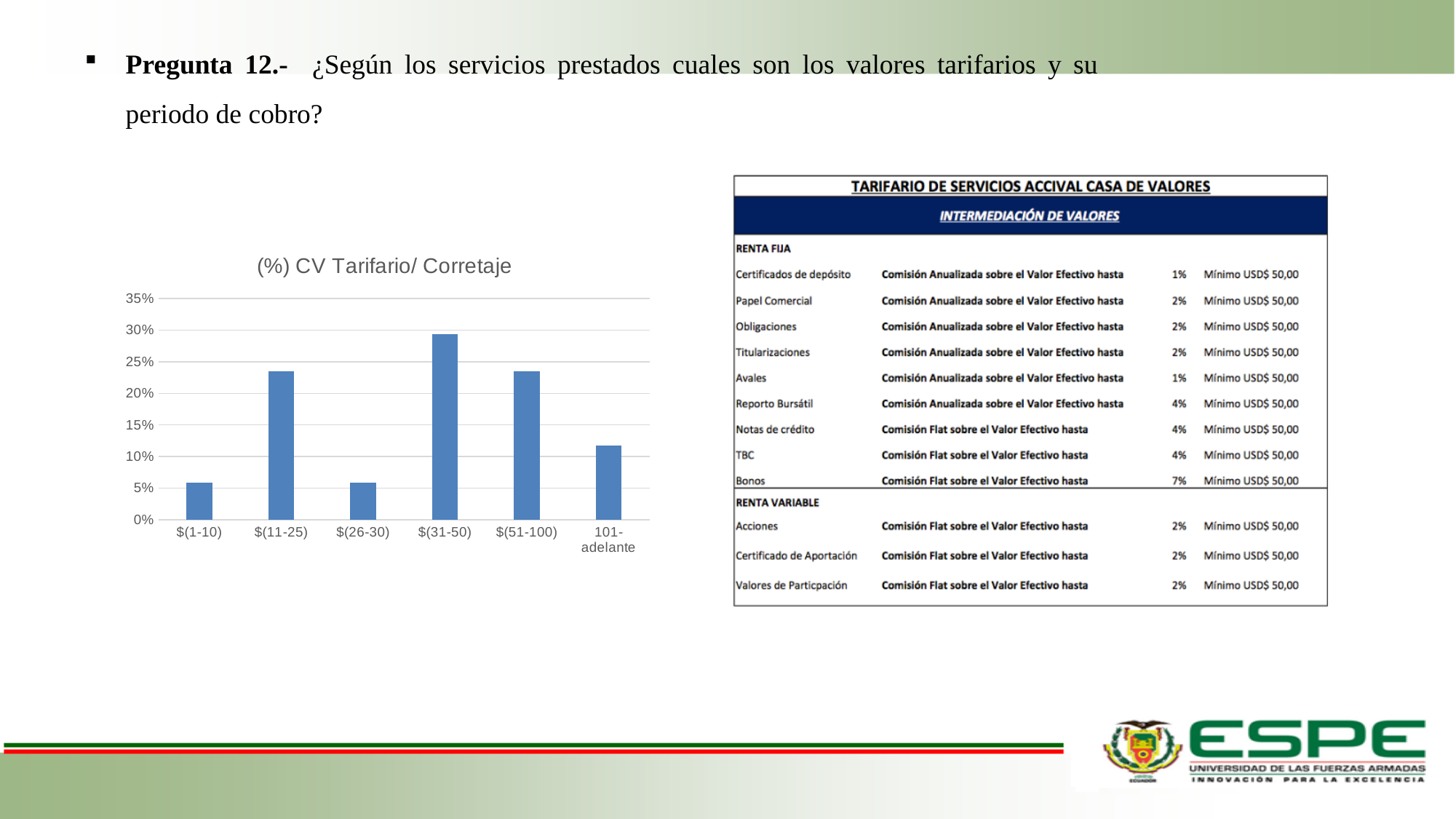
Is the value for $(31-50) greater or less than 25%? greater Which is larger, the value for $(31-50) or the value for $(11-25)? $(31-50) What is the title of the chart? (%) CV Tarifario/ Corretaje Which is larger, the value for $(51-100) or the value for 101-adelante? $(51-100) Which category has the highest value in the chart? $(31-50) Is the value for 101-adelante greater or less than 15%? less Is the value for $(11-25) greater or less than 20%? greater Which is larger, the value for $(11-25) or the value for $(26-30)? $(11-25) How many categories are shown on the x axis of the chart? 6 What kind of chart is shown on the slide? bar chart